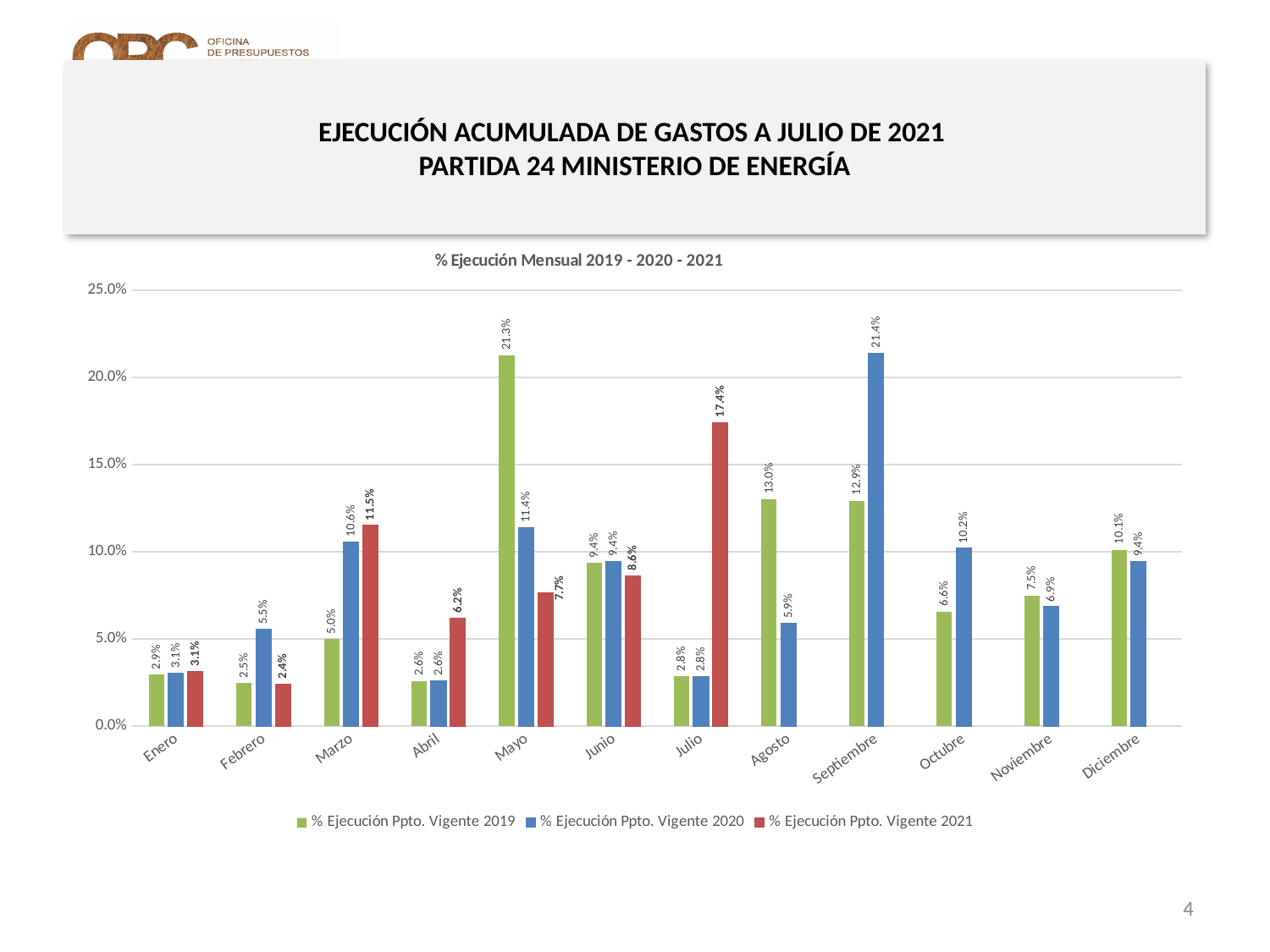
What is the value for % Ejecución Ppto. Vigente 2019 in Mayo? 21.3% What is the difference between the 2021 and 2019 values in Julio? 14.6% What is the value for % Ejecución Ppto. Vigente 2021 in Marzo? 11.5% How many series does the legend list? 3 What is the value for % Ejecución Ppto. Vigente 2020 in Septiembre? 21.4% How many months are shown on the x axis? 12 In which month is the % Ejecución Ppto. Vigente 2021 series highest? Julio What is the title of the chart? % Ejecución Mensual 2019 - 2020 - 2021 Which is larger in Marzo: the 2020 value or the 2021 value? 2021 value (11.5%) In which month is the % Ejecución Ppto. Vigente 2019 series lowest? Febrero What is the value for % Ejecución Ppto. Vigente 2021 in Julio? 17.4% What kind of chart is shown? Bar chart